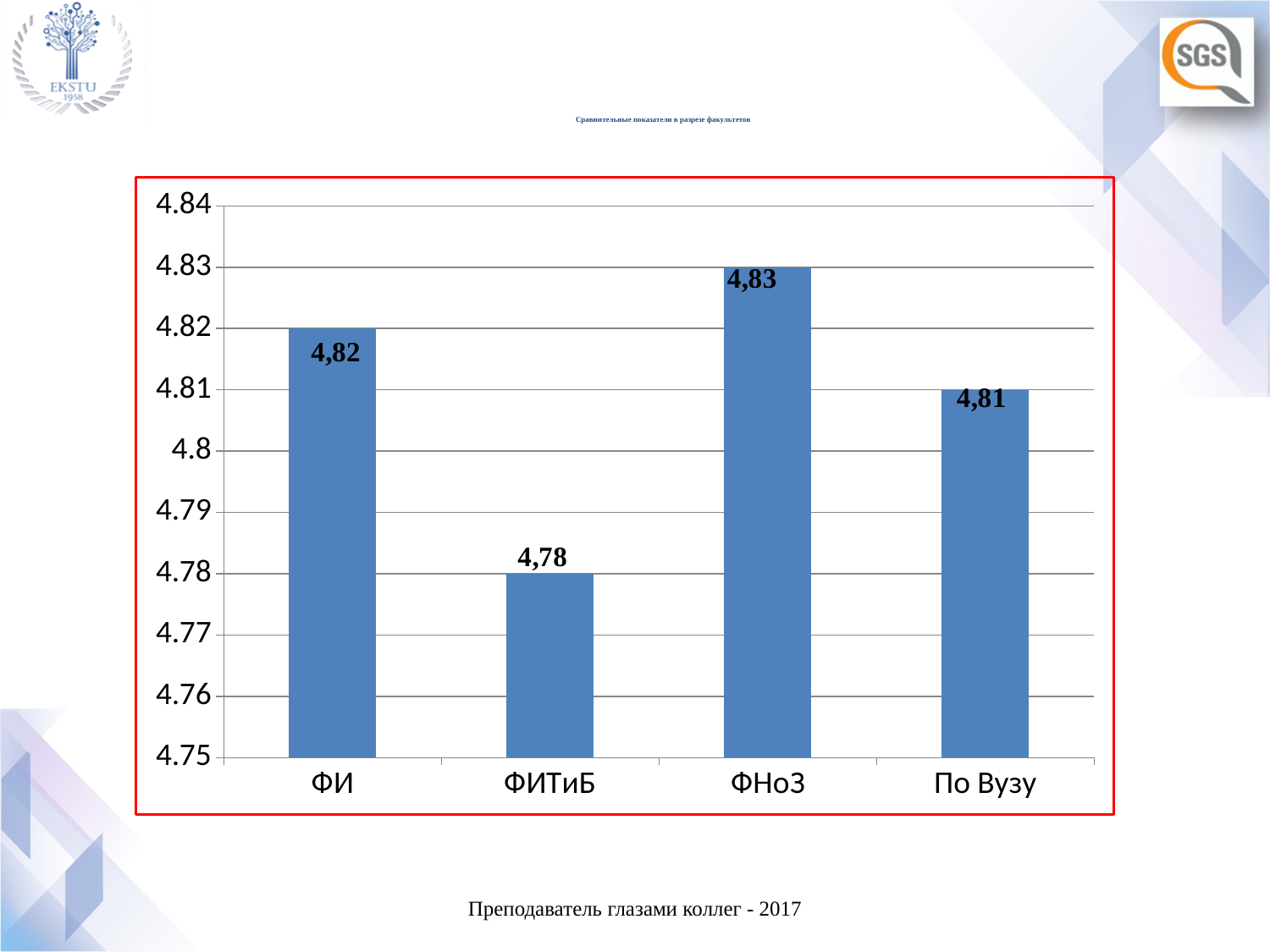
What is the value for ФИ? 4,82 Which category has the highest value? ФНоЗ What is the difference between the values for ФНоЗ and ФИТиБ? 0,05 What is the difference between the values for ФИ and По Вузу? 0,01 What is the value for ФИТиБ? 4,78 What is the value for ФНоЗ? 4,83 Which category has the lowest value? ФИТиБ Is the value for ФИТиБ greater or less than 4.8? less How many categories are shown on the x axis? 4 Which is larger, the value for ФИ or the value for ФИТиБ? ФИ What is the value for По Вузу? 4,81 What kind of chart is shown on the slide? bar chart